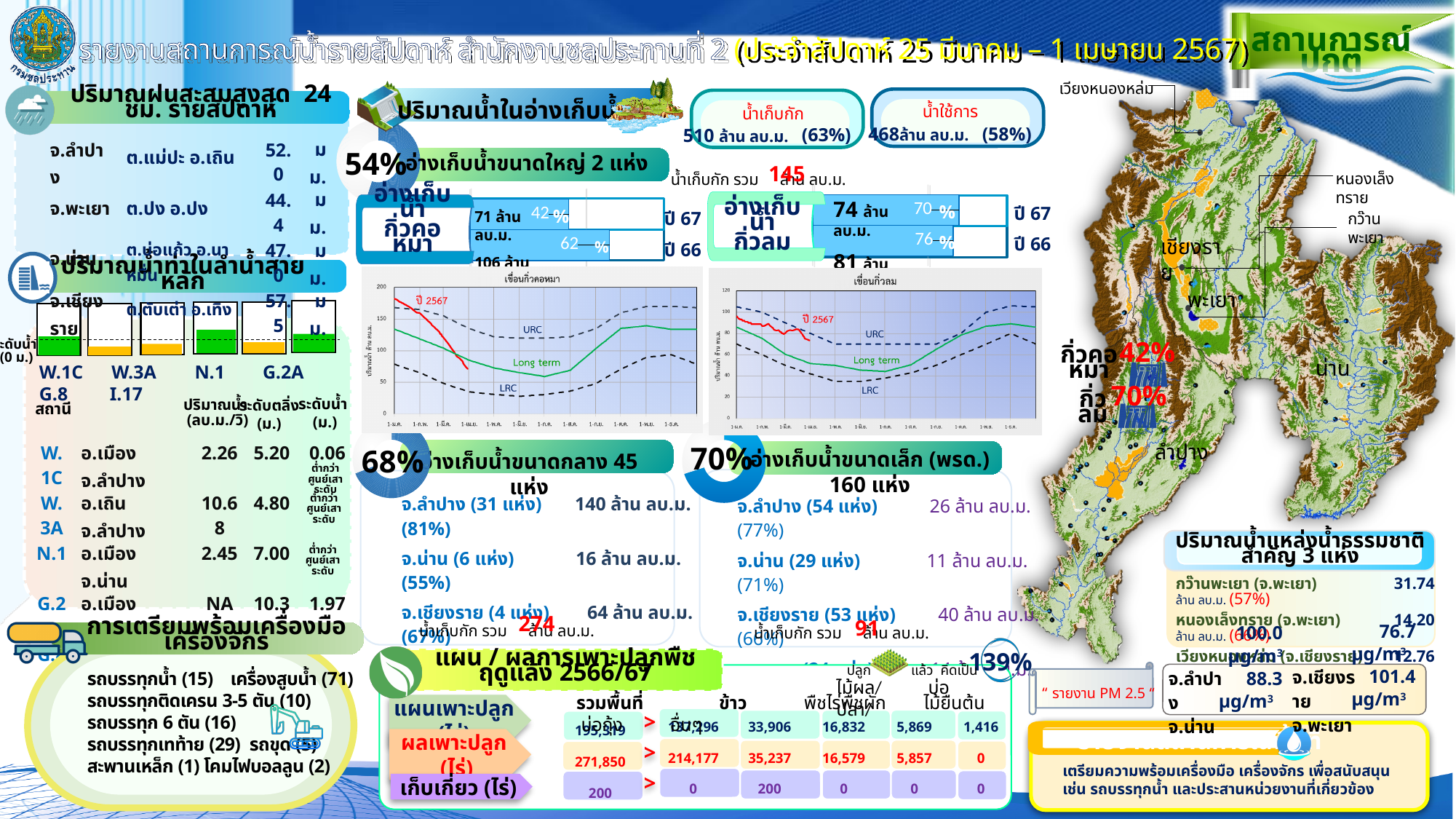
In the เขื่อนกิ่วคอหมา line chart, does the red ปี 2567 line rise or fall from 1 ม.ค. to 1 เม.ย.? fall In the อ่างเก็บน้ำกิ่วคอหมา bar chart, what volume is shown for ปี 66? 106 ล้าน ลบ.ม. What kind of chart is the เขื่อนกิ่วคอหมา chart in the middle of the slide? line chart In the เขื่อนกิ่วลม line chart, does the red ปี 2567 line rise or fall from 1 ม.ค. to 1 เม.ย.? fall In the เขื่อนกิ่วลม line chart, is the red ปี 2567 line at 1 เม.ย. greater or less than 60? greater In the อ่างเก็บน้ำกิ่วลม bar chart, what percentage is shown for ปี 66? 76% In the อ่างเก็บน้ำกิ่วคอหมา bar chart, which year has the larger stored volume, ปี 67 or ปี 66? ปี 66 What is the highest value shown on the y axis of the เขื่อนกิ่วลม line chart? 120 In the อ่างเก็บน้ำกิ่วคอหมา bar chart, what is the difference in volume between ปี 66 and ปี 67? 35 ล้าน ลบ.ม. In the อ่างเก็บน้ำกิ่วลม bar chart, what is the difference in volume between ปี 66 (81 ล้าน ลบ.ม.) and ปี 67 (74 ล้าน ลบ.ม.)? 7 ล้าน ลบ.ม. In the เขื่อนกิ่วคอหมา line chart, is the red ปี 2567 line at 1 เม.ย. greater or less than 100? less In the อ่างเก็บน้ำกิ่วคอหมา bar chart, what percentage is shown for ปี 67? 42%